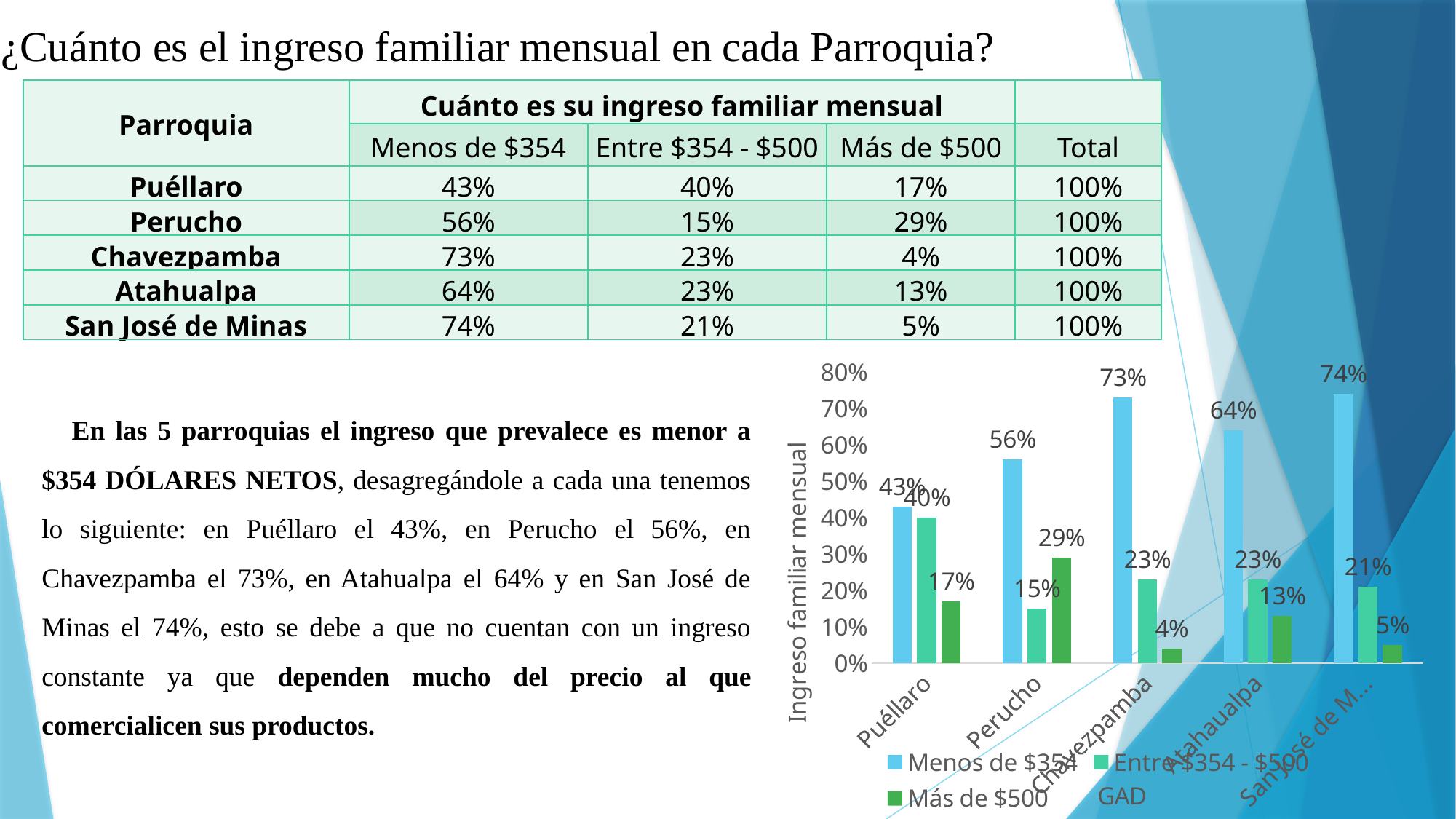
For Perucho, which is larger in the chart: 'Entre $354 - $500' or 'Más de $500'? Más de $500 In the chart, what is the value of 'Menos de $354' for Chavezpamba? 73% In the chart, what is the value of 'Entre $354 - $500' for San José de Minas? 21% Is the value of 'Menos de $354' for Atahualpa greater or less than 50%? greater In the chart, what is the difference between 'Menos de $354' and 'Entre $354 - $500' for Puéllaro? 3% Which parroquia has the lowest value for 'Más de $500' in the chart? Chavezpamba Which parroquia has the highest value for 'Menos de $354' in the chart? San José de Minas How many series does the chart's legend list? 3 What is the title of the chart's vertical axis? Ingreso familiar mensual What kind of chart is shown on the slide? bar chart In the chart, what is the value of 'Más de $500' for Perucho? 29% How many parroquias (categories) are plotted on the x axis of the chart? 5